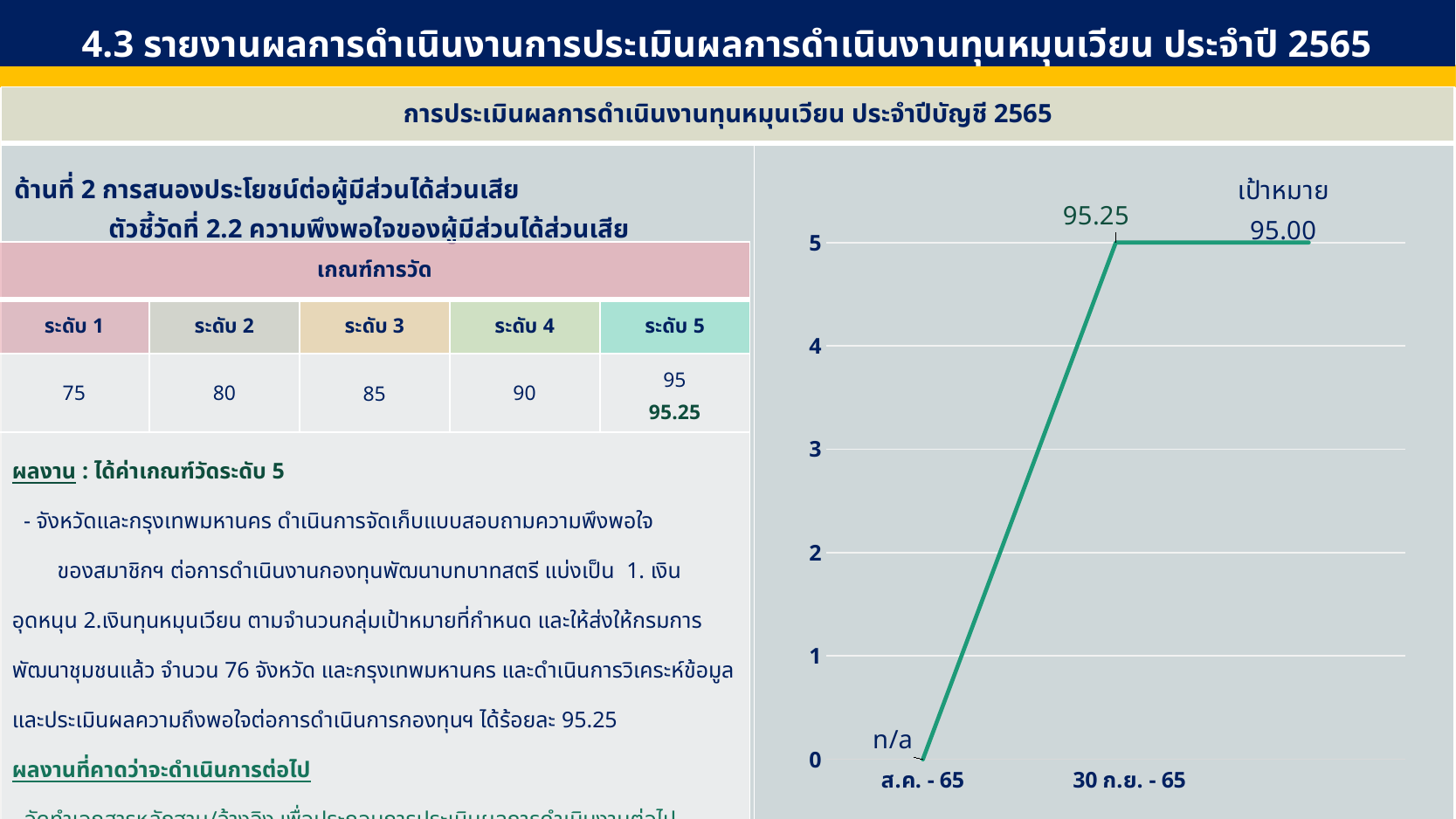
Which data label is larger in the line chart, the one for 30 ก.ย. - 65 or the one for เป้าหมาย? 30 ก.ย. - 65 Is the plotted level for ส.ค. - 65 in the line chart greater or less than 1? less What data label is shown for 30 ก.ย. - 65 in the line chart? 95.25 What label is shown at the ส.ค. - 65 point in the line chart? n/a What is the highest tick value on the y axis of the line chart? 5 How many category labels are shown on the x axis of the line chart? 2 Does the line in the chart rise or fall from ส.ค. - 65 to 30 ก.ย. - 65? rise What kind of chart is shown on the right side of the slide? line chart Is the plotted level for 30 ก.ย. - 65 in the line chart greater or less than 4? greater What is the difference between the data labels for 30 ก.ย. - 65 and เป้าหมาย in the line chart? 0.25 What colour is the line in the line chart? green What data label is shown for เป้าหมาย in the line chart? 95.00